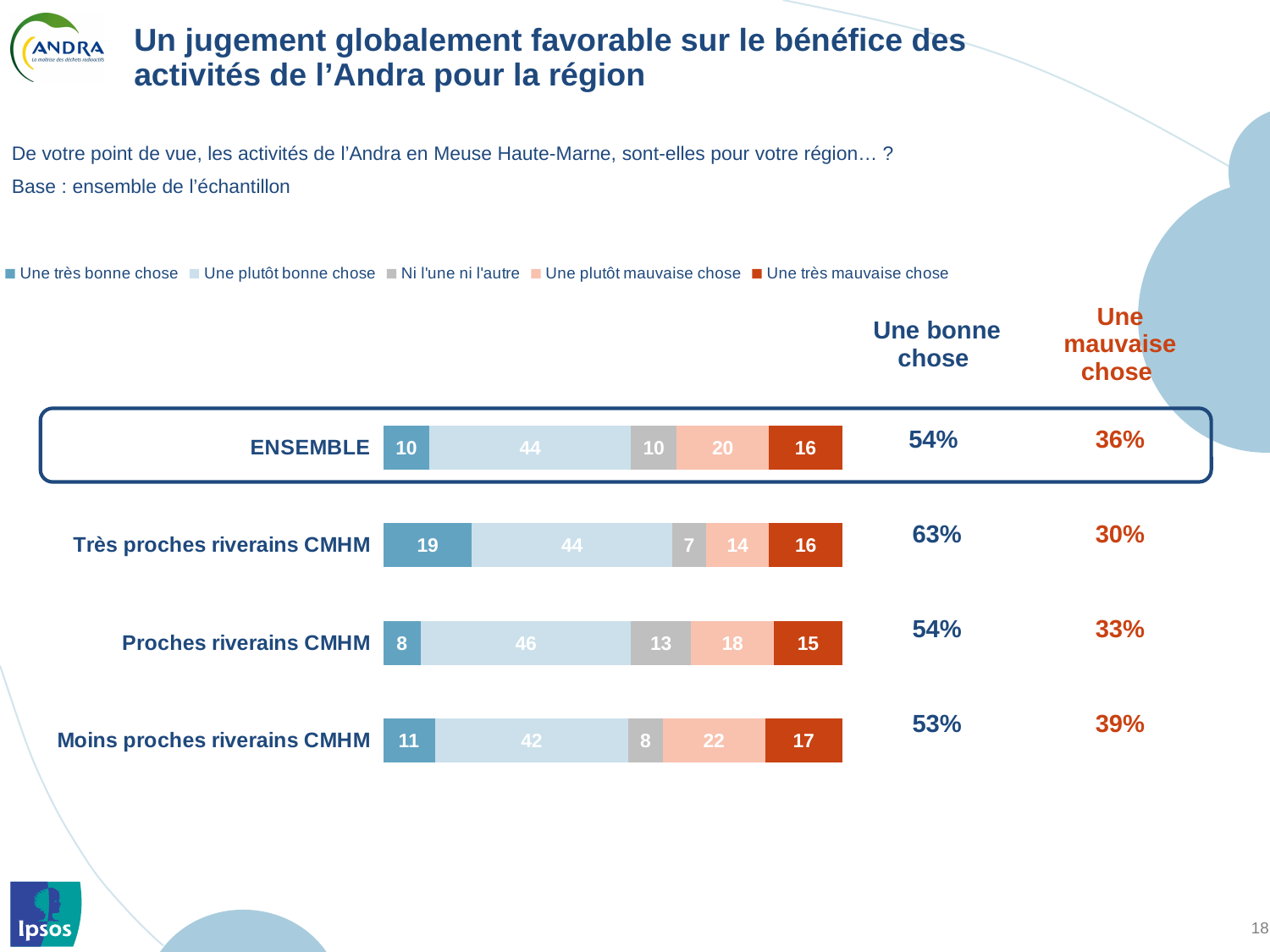
What is the value of 'Une très mauvaise chose' for Moins proches riverains CMHM? 17 What type of chart is shown on the slide? Stacked bar chart How many categories (rows) are plotted in the chart? 4 What is the value of 'Une plutôt bonne chose' for Proches riverains CMHM? 46 Which category has the lowest value for 'Une plutôt mauvaise chose'? Très proches riverains CMHM How many series does the legend list? 5 What is the total of the stacked bar for ENSEMBLE? 100 What is the value of 'Une très bonne chose' for Très proches riverains CMHM? 19 What is the difference between the 'Une plutôt mauvaise chose' values for Moins proches riverains CMHM and Très proches riverains CMHM? 8 Which category has the highest value for 'Une très bonne chose'? Très proches riverains CMHM What is the value of 'Ni l'une ni l'autre' for ENSEMBLE? 10 Which is larger: the 'Ni l'une ni l'autre' value for Proches riverains CMHM or for Moins proches riverains CMHM? Proches riverains CMHM